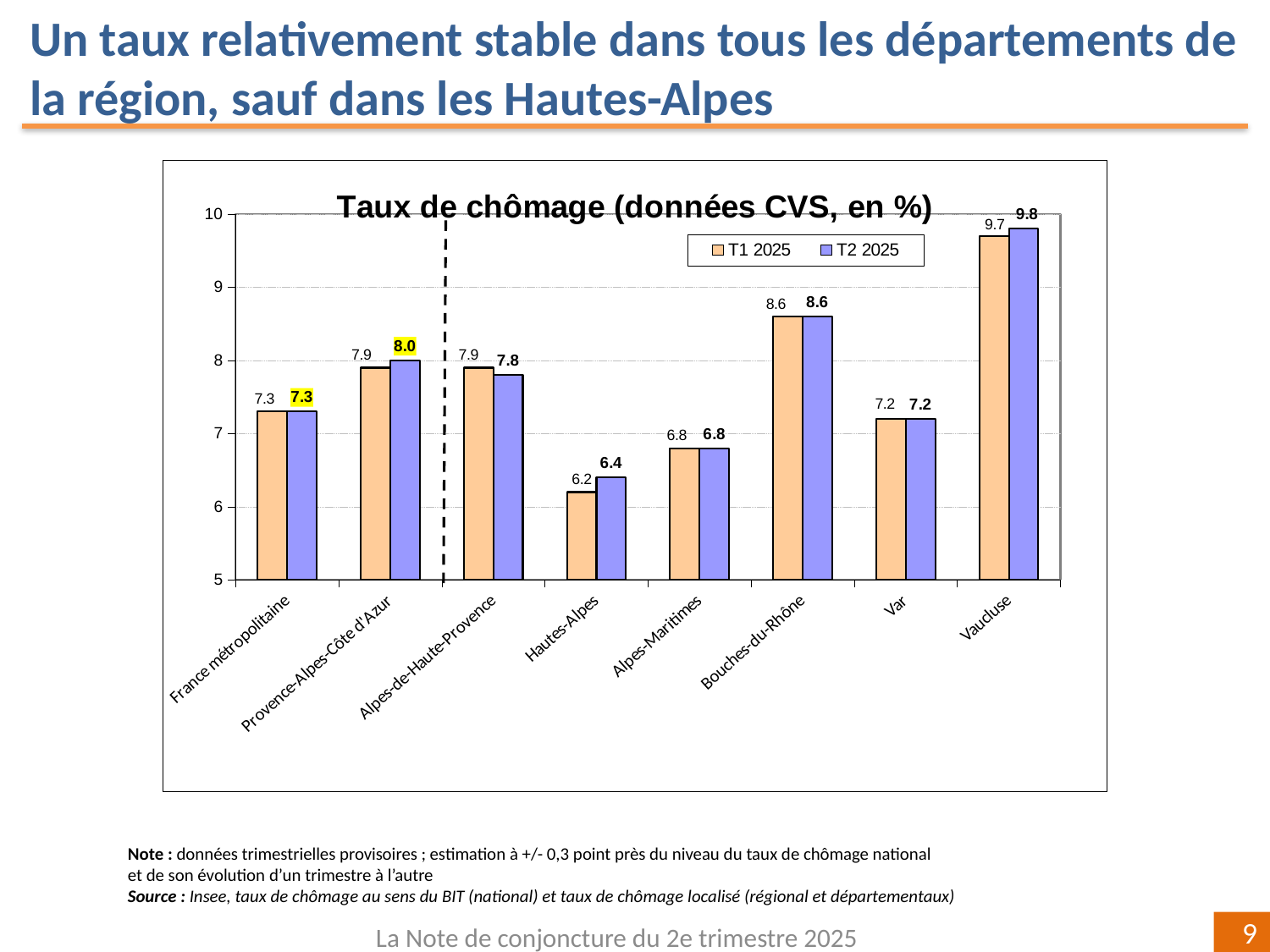
How many categories are shown on the x axis? 8 Which category has the highest T2 2025 unemployment rate? Vaucluse Which category has the lowest T1 2025 unemployment rate? Hautes-Alpes Which is larger for Alpes-de-Haute-Provence: the T1 2025 value or the T2 2025 value? T1 2025 What is the difference between the T2 2025 and T1 2025 values for Hautes-Alpes? 0.2 What is the T2 2025 unemployment rate for Hautes-Alpes? 6.4 What kind of chart is shown on the slide? bar chart What is the title of the chart? Taux de chômage (données CVS, en %) How many series does the legend list? 2 What is the T2 2025 value for Provence-Alpes-Côte d'Azur? 8.0 What is the T1 2025 unemployment rate for Vaucluse? 9.7 Is the T2 2025 value for Bouches-du-Rhône greater or less than 8? greater